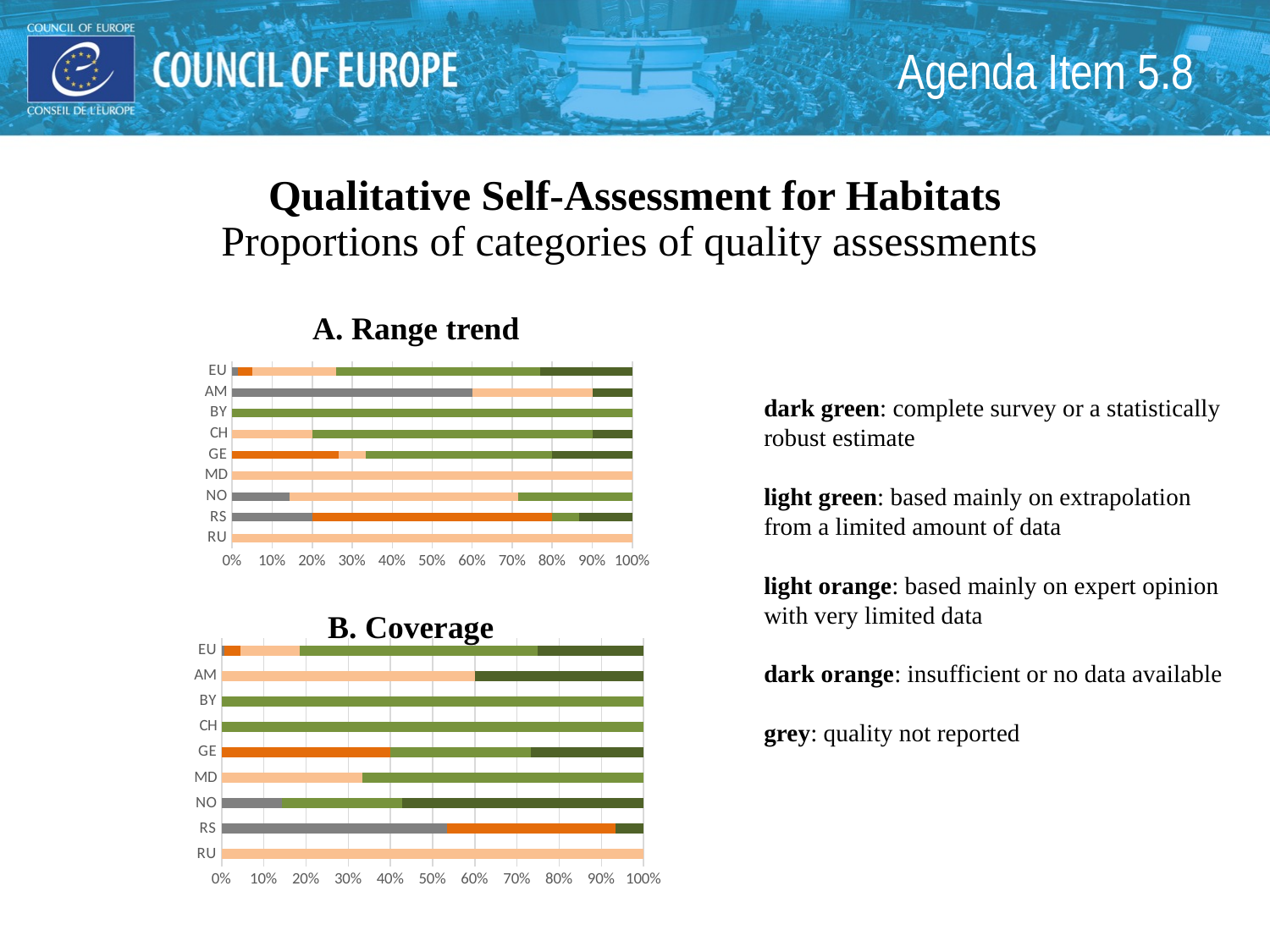
In the "A. Range trend" chart, is the grey segment for NO greater or less than 20%? less In the "A. Range trend" chart, which has the larger grey segment, AM or NO? AM How many categories (countries/regions) are shown on the y axis of the "B. Coverage" chart? 9 In the "B. Coverage" chart, is the grey segment for RS greater or less than 50%? greater In the "B. Coverage" chart, which has the larger grey segment, NO or RS? RS In the "B. Coverage" chart, which category has the largest grey segment? RS What is the title of the lower chart on the slide? B. Coverage In the "A. Range trend" chart, is the grey segment for AM greater or less than 50%? greater What kind of chart is "A. Range trend"? bar chart According to the slide, which colour in the charts indicates "quality not reported"? grey In the "A. Range trend" chart, which category has the largest grey segment? AM